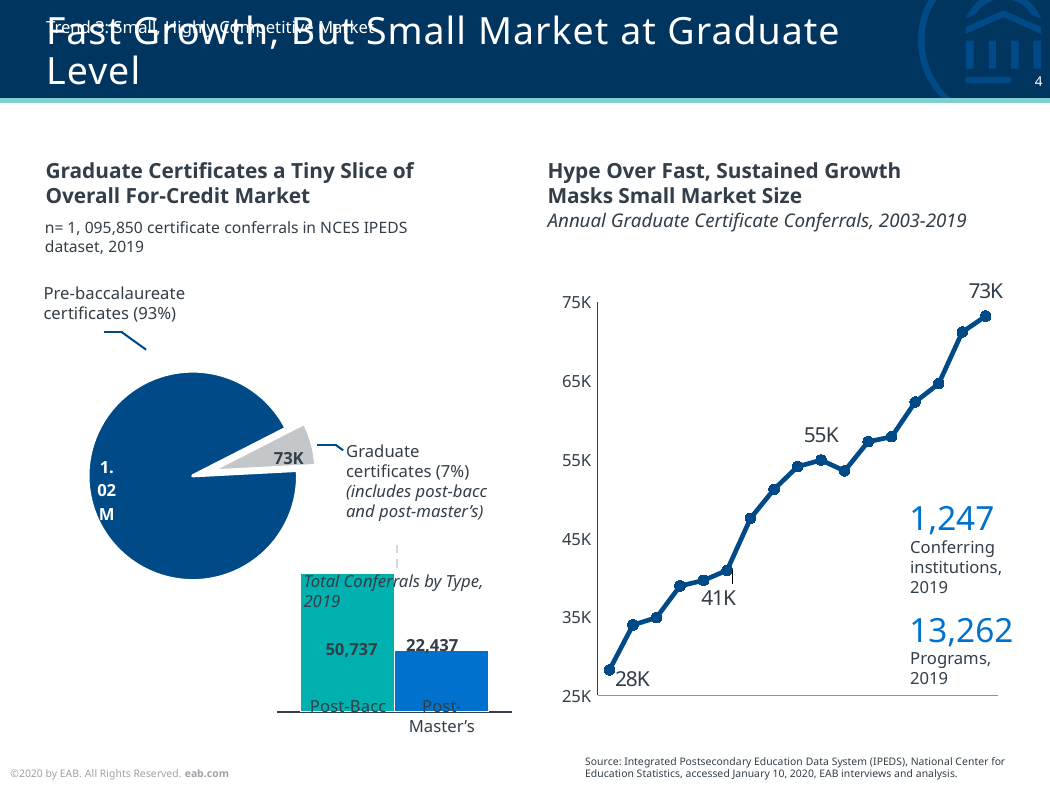
In the pie chart on the left, what value is shown for the Graduate certificates slice? 73K What kind of chart is 'Total Conferrals by Type, 2019'? Bar chart In the pie chart on the left, what share of the pie do Graduate certificates represent? 7% In the 'Annual Graduate Certificate Conferrals, 2003-2019' chart, what is the value labeled at the start of the line in 2003? 28K In the pie chart on the left, what share of the pie do Pre-baccalaureate certificates represent? 93% In the 'Total Conferrals by Type, 2019' bar chart, what is the value for Post Master's? 22,437 In the 'Total Conferrals by Type, 2019' bar chart, what is the difference between the Post-Bacc and Post Master's values? 28,300 In the 'Total Conferrals by Type, 2019' bar chart, what is the value for Post-Bacc? 50,737 In the 'Annual Graduate Certificate Conferrals, 2003-2019' chart, do the values generally rise or fall from 2003 to 2019? Rise In the 'Annual Graduate Certificate Conferrals, 2003-2019' chart, what is the value labeled at the end of the line in 2019? 73K What kind of chart is 'Annual Graduate Certificate Conferrals, 2003-2019'? Line chart In the pie chart on the left, which slice is larger: Pre-baccalaureate certificates or Graduate certificates? Pre-baccalaureate certificates